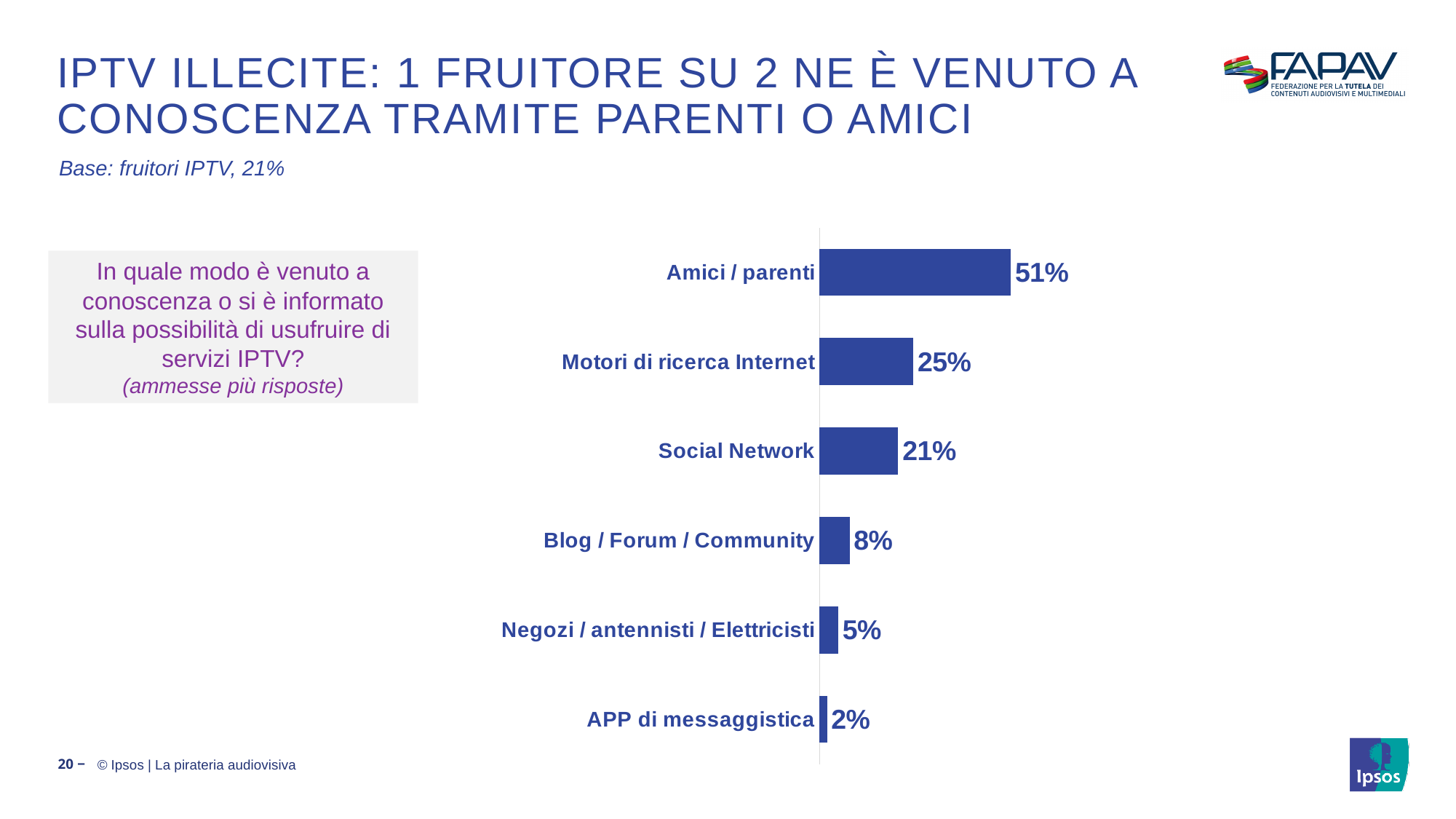
How many categories are shown in the chart? 6 Which category has the highest value? Amici / parenti What is the value for Negozi / antennisti / Elettricisti? 5% What is the value for Blog / Forum / Community? 8% What kind of chart is shown on the slide? Bar chart What is the value for Social Network? 21% What is the difference between the values for Amici / parenti and Motori di ricerca Internet? 26% What is the value for APP di messaggistica? 2% Which category has the lowest value? APP di messaggistica What is the value for Amici / parenti? 51% What is the value for Motori di ricerca Internet? 25% Which is larger, the value for Social Network or the value for Blog / Forum / Community? Social Network